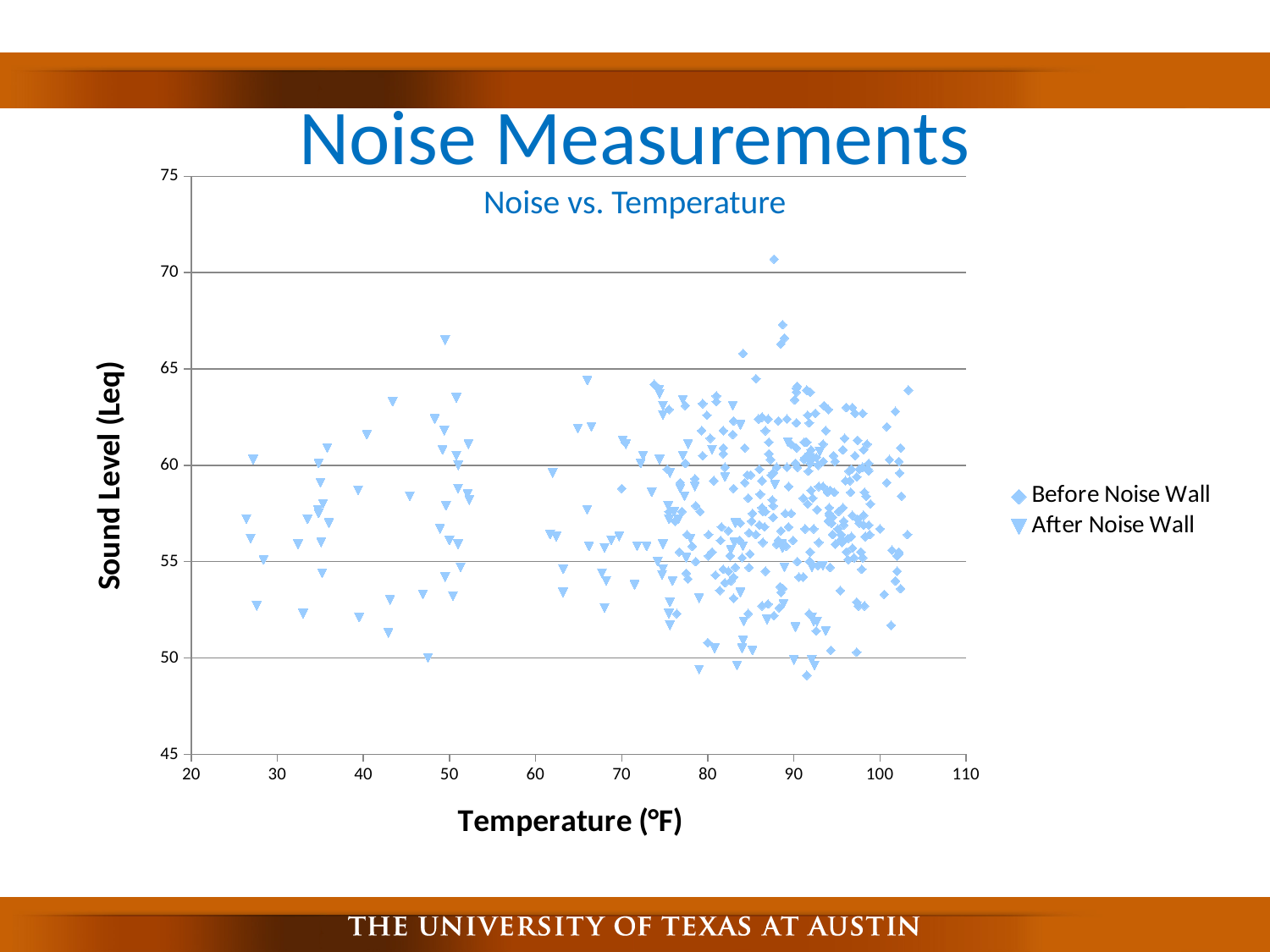
Which series has points plotted at temperatures below 60°F? After Noise Wall Is the highest Before Noise Wall point greater or less than 70 on the Sound Level axis? greater What are the two series named in the legend? Before Noise Wall and After Noise Wall How many series does the legend list? 2 Do any points on the chart fall below 50 on the Sound Level axis? Yes What kind of chart is shown on the slide? Scatter chart Is the lowest After Noise Wall point greater or less than 50 on the Sound Level axis? less What is the title of the chart? Noise vs. Temperature Which series contains the single highest point on the chart? Before Noise Wall